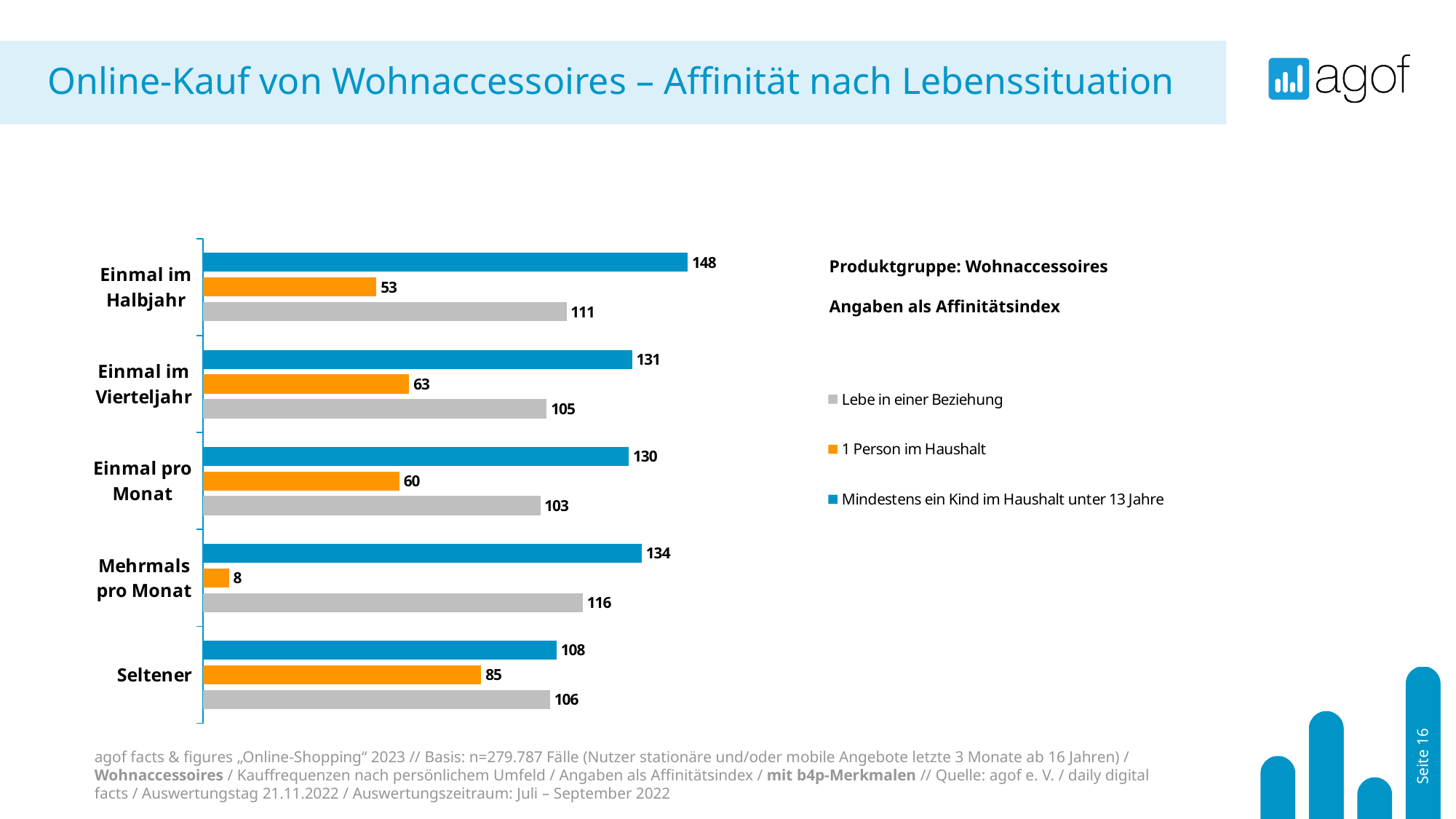
Which category has the highest value for 'Lebe in einer Beziehung'? Mehrmals pro Monat What is the value for '1 Person im Haushalt' in the 'Mehrmals pro Monat' category? 8 What is the value for 'Lebe in einer Beziehung' in the 'Seltener' category? 106 What is the affinity index for 'Mindestens ein Kind im Haushalt unter 13 Jahre' in the 'Einmal im Halbjahr' category? 148 Which category has the lowest value for 'Mindestens ein Kind im Haushalt unter 13 Jahre'? Seltener What is the difference between the 'Mindestens ein Kind im Haushalt unter 13 Jahre' and 'Lebe in einer Beziehung' values in the 'Einmal im Halbjahr' category? 37 How many series does the legend list? 3 What kind of chart is shown on the slide? Bar chart How many frequency categories are shown on the chart? 5 Which colour represents '1 Person im Haushalt' in the chart? Orange Which category has the highest value for '1 Person im Haushalt'? Seltener In the 'Einmal im Vierteljahr' category, which is larger: 'Lebe in einer Beziehung' or '1 Person im Haushalt'? Lebe in einer Beziehung